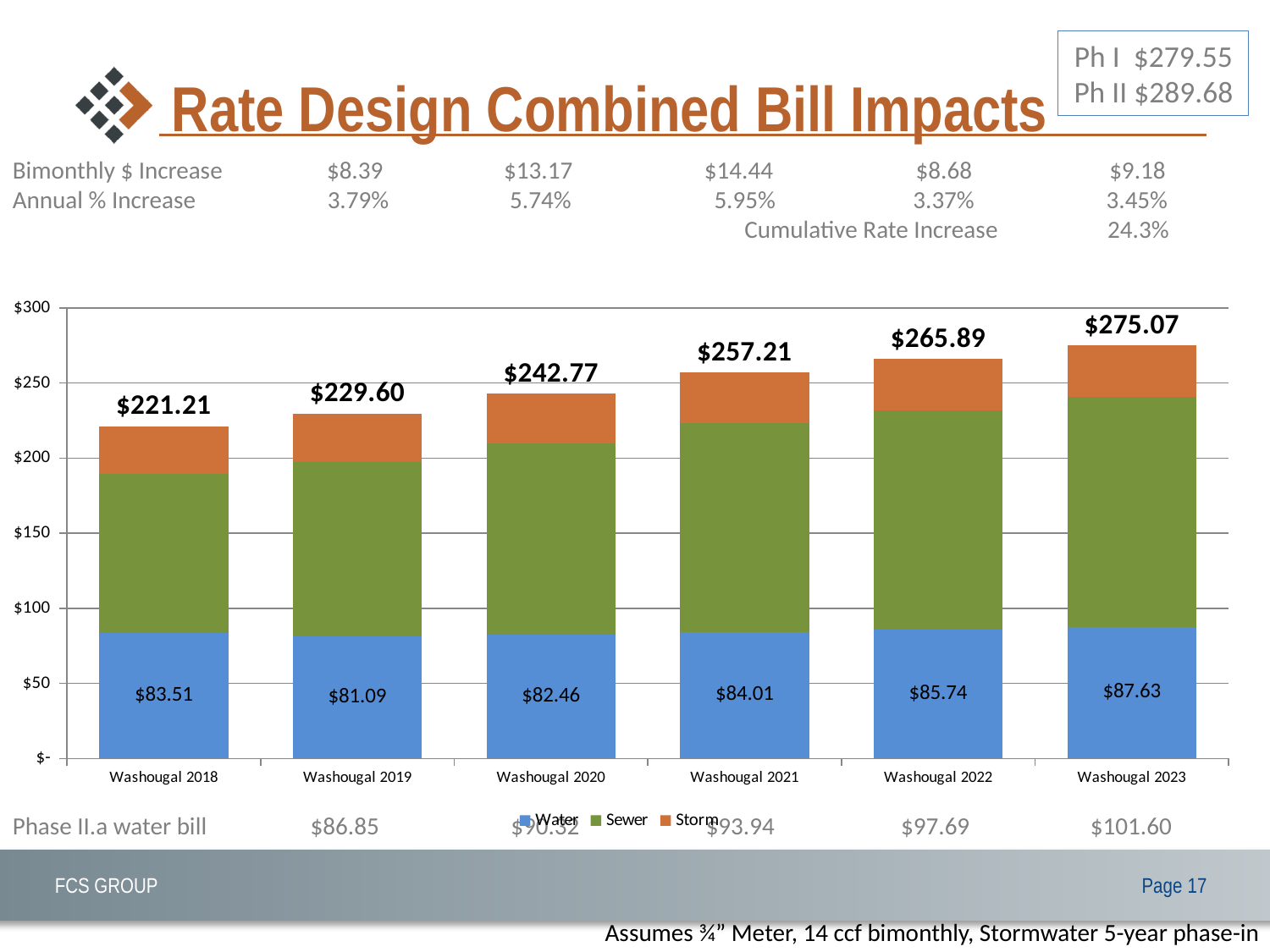
Which year has the lowest Water value? Washougal 2019 What is the total combined bill shown above the bar for Washougal 2023? $275.07 Do the total combined bills rise or fall from Washougal 2018 to Washougal 2023? rise Which is larger, the Water value for Washougal 2021 or Washougal 2022? Washougal 2022 What is the difference between the Water value for Washougal 2023 and Washougal 2019? $6.54 What is the difference between the total combined bill for Washougal 2023 and Washougal 2018? $53.86 How many years (bars) are shown in the chart? 6 What is the Water value labeled on the bar for Washougal 2020? $82.46 Which year has the highest total combined bill? Washougal 2023 Is the total combined bill for Washougal 2021 greater or less than $250? greater How many series does the legend list? 3 What is the total combined bill shown above the bar for Washougal 2018? $221.21